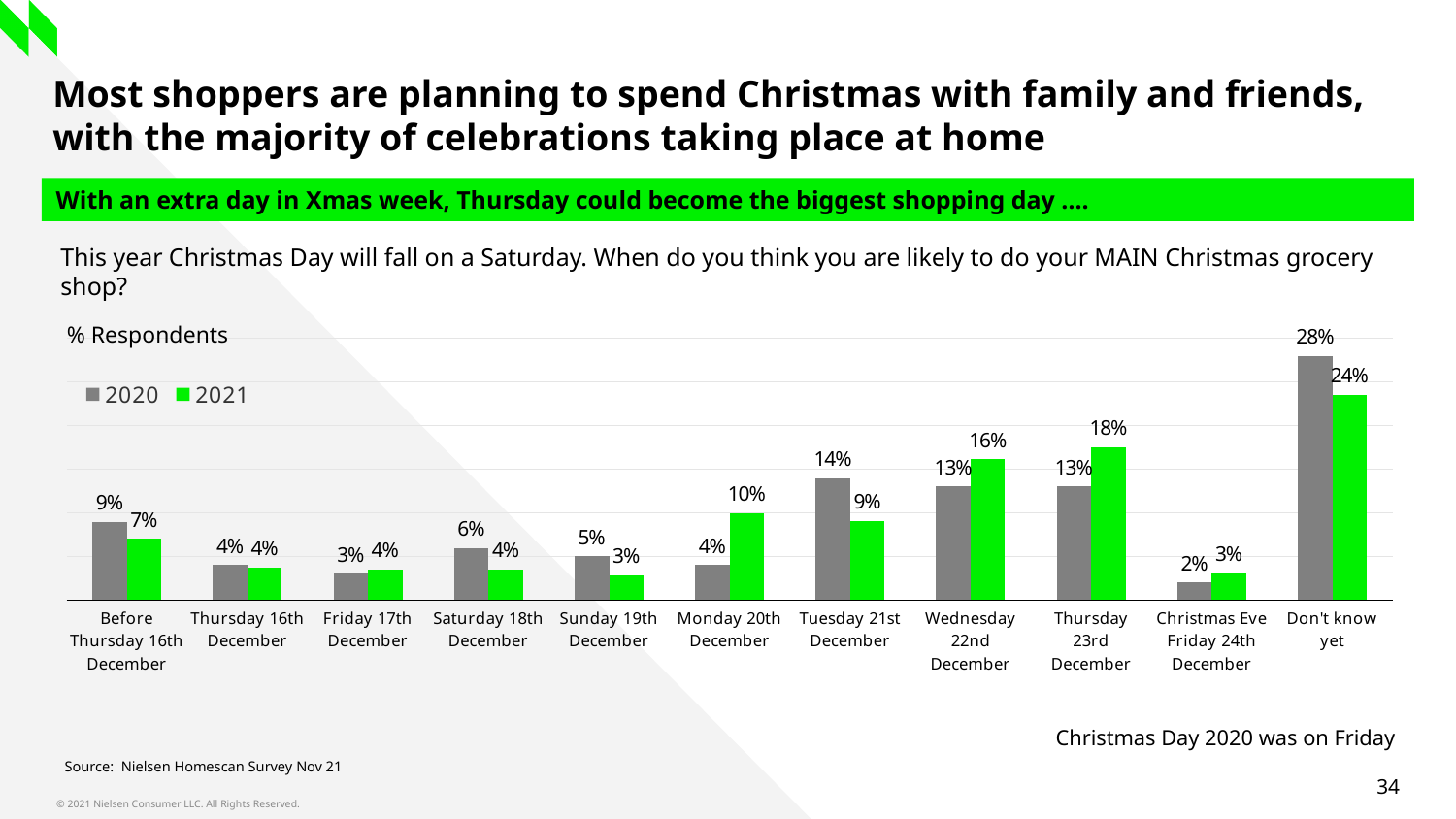
What percentage of respondents in 2021 said they would do their main Christmas grocery shop on Thursday 23rd December? 18% For Wednesday 22nd December, which series has the larger value, 2020 or 2021? 2021 What is the 2021 value for Monday 20th December? 10% What type of chart is shown on the slide? Bar chart What is the 2020 value for Tuesday 21st December? 14% How many series does the chart's legend list? 2 What is the difference between the 2021 and 2020 values for Thursday 23rd December? 5 percentage points Which category has the highest value for the 2020 series? Don't know yet How many categories are shown on the x axis of the chart? 11 Which category has the lowest value for the 2020 series? Christmas Eve Friday 24th December For Tuesday 21st December, which series has the larger value, 2020 or 2021? 2020 Which colour represents the 2021 series in the chart? Green